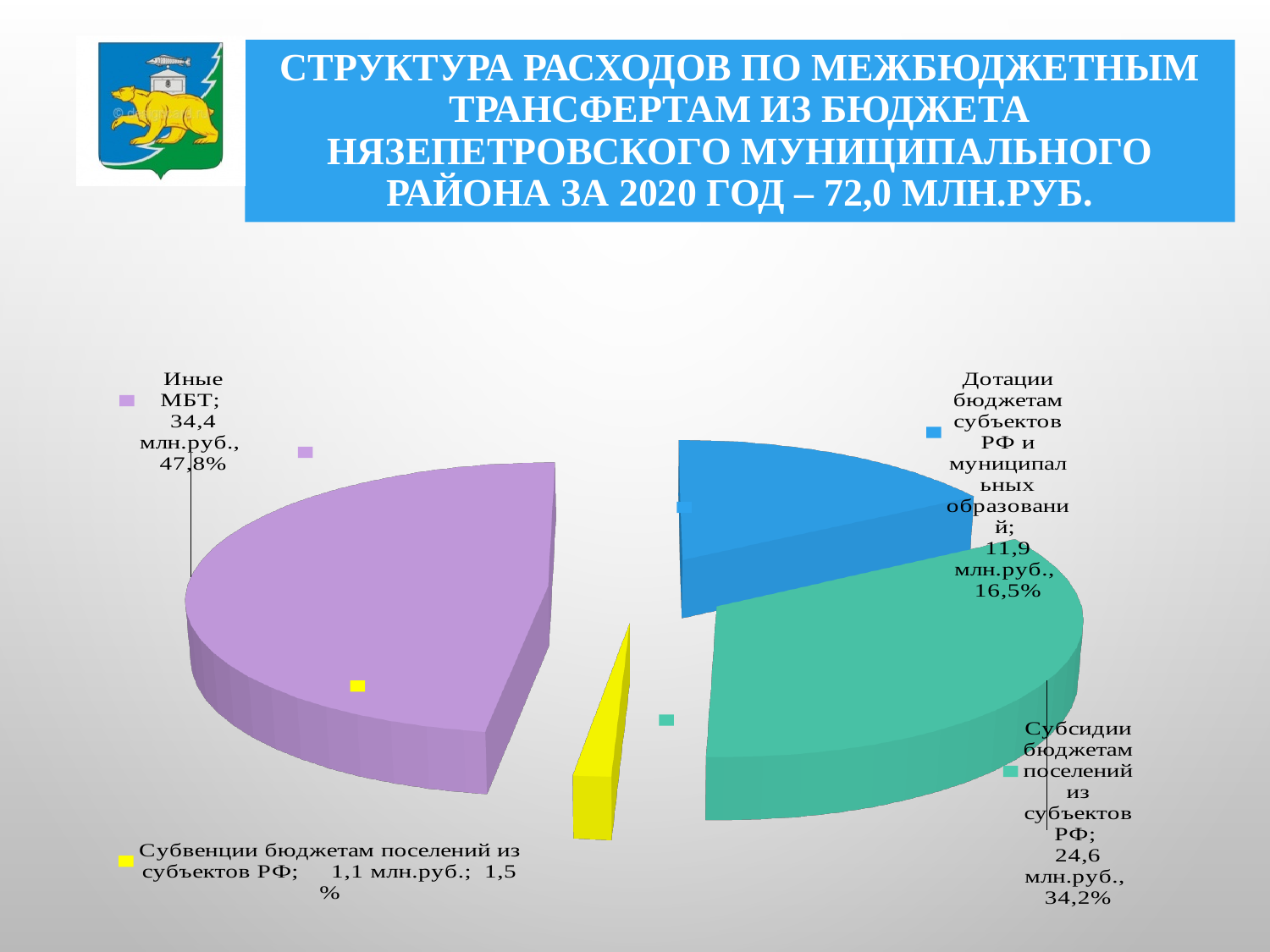
Что больше: сумма по «Субсидии бюджетам поселений из субъектов РФ» или по «Дотации бюджетам субъектов РФ и муниципальных образований»? Субсидии бюджетам поселений из субъектов РФ На сколько млн.руб. сумма по «Иные МБТ» больше суммы по «Субсидии бюджетам поселений из субъектов РФ»? 9,8 млн.руб. Какой тип диаграммы показан на слайде? Круговая диаграмма Какова сумма по категории «Иные МБТ»? 34,4 млн.руб. Каким цветом на диаграмме показан сектор «Иные МБТ»? Фиолетовым (сиреневым) Какую долю составляют «Субвенции бюджетам поселений из субъектов РФ»? 1,5 % Сколько категорий (секторов) показано на круговой диаграмме? 4 Какая категория имеет наибольшую долю на диаграмме? Иные МБТ Какую долю составляют «Субсидии бюджетам поселений из субъектов РФ»? 34,2% Какая категория имеет наименьшую долю на диаграмме? Субвенции бюджетам поселений из субъектов РФ Какова сумма по категории «Дотации бюджетам субъектов РФ и муниципальных образований»? 11,9 млн.руб. Какой общий объём межбюджетных трансфертов указан в заголовке слайда? 72,0 млн.руб.